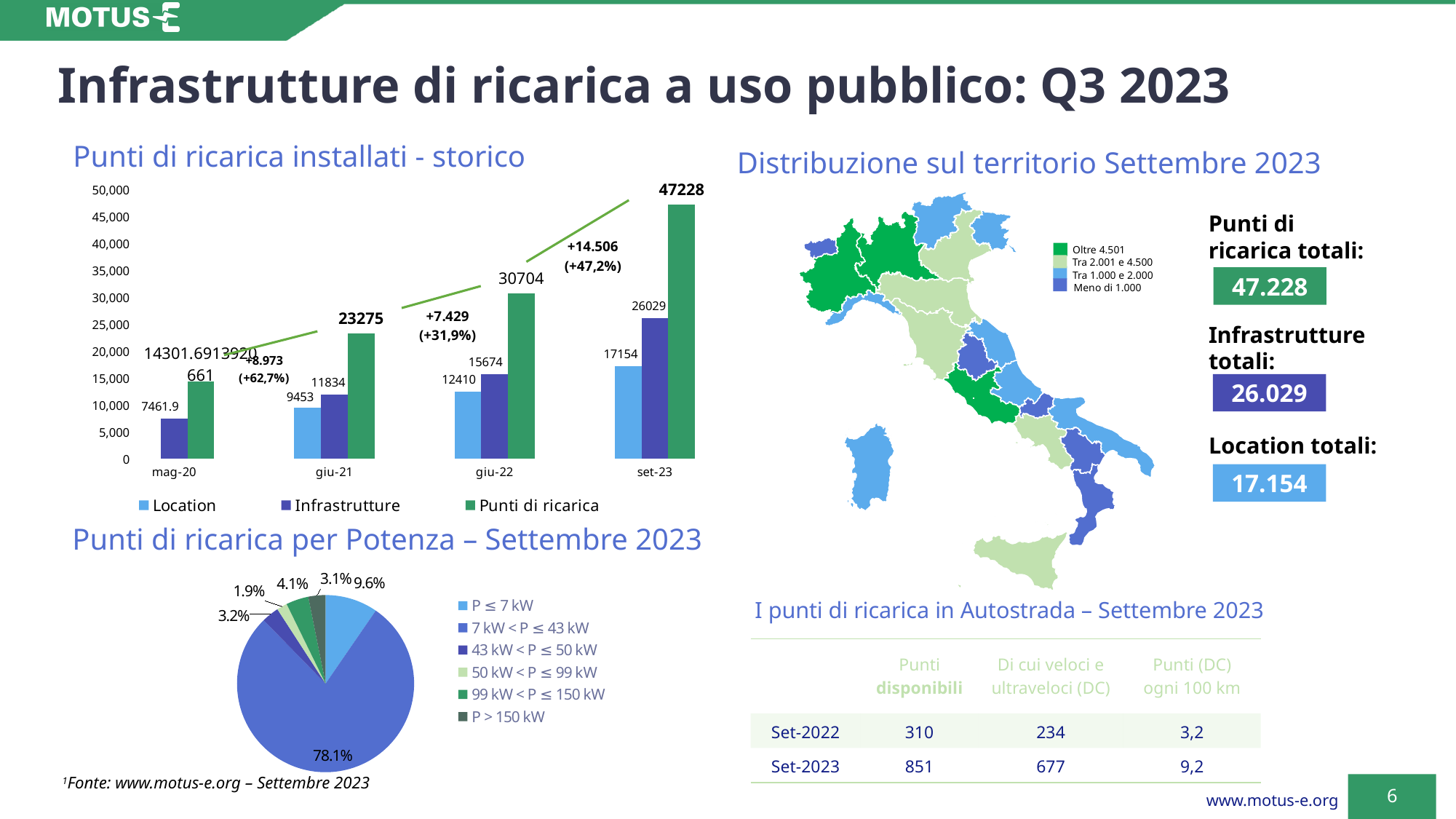
In the 'Punti di ricarica installati - storico' chart, does the Punti di ricarica value rise or fall from mag-20 to set-23? rise In the 'Punti di ricarica installati - storico' chart, what is the value of Punti di ricarica for set-23? 47228 In the 'Punti di ricarica per Potenza – Settembre 2023' pie chart, what share does the P ≤ 7 kW slice have? 9.6% In the 'Punti di ricarica installati - storico' chart, which is larger for giu-21: Infrastrutture or Location? Infrastrutture In the 'Punti di ricarica installati - storico' chart, what is the value of Location for giu-21? 9453 In the 'Punti di ricarica installati - storico' chart, which period has the highest value for Punti di ricarica? set-23 In the 'Punti di ricarica installati - storico' chart, what is the value of Infrastrutture for giu-22? 15674 In the 'Punti di ricarica per Potenza – Settembre 2023' pie chart, what share does the 7 kW < P ≤ 43 kW slice have? 78.1% How many categories does the legend of the 'Punti di ricarica per Potenza – Settembre 2023' pie chart list? 6 What kind of chart is 'Punti di ricarica installati - storico'? bar chart In the 'Punti di ricarica installati - storico' chart, how many series does the legend list? 3 In the 'Punti di ricarica installati - storico' chart, what is the difference between Punti di ricarica for set-23 and giu-22? 16524